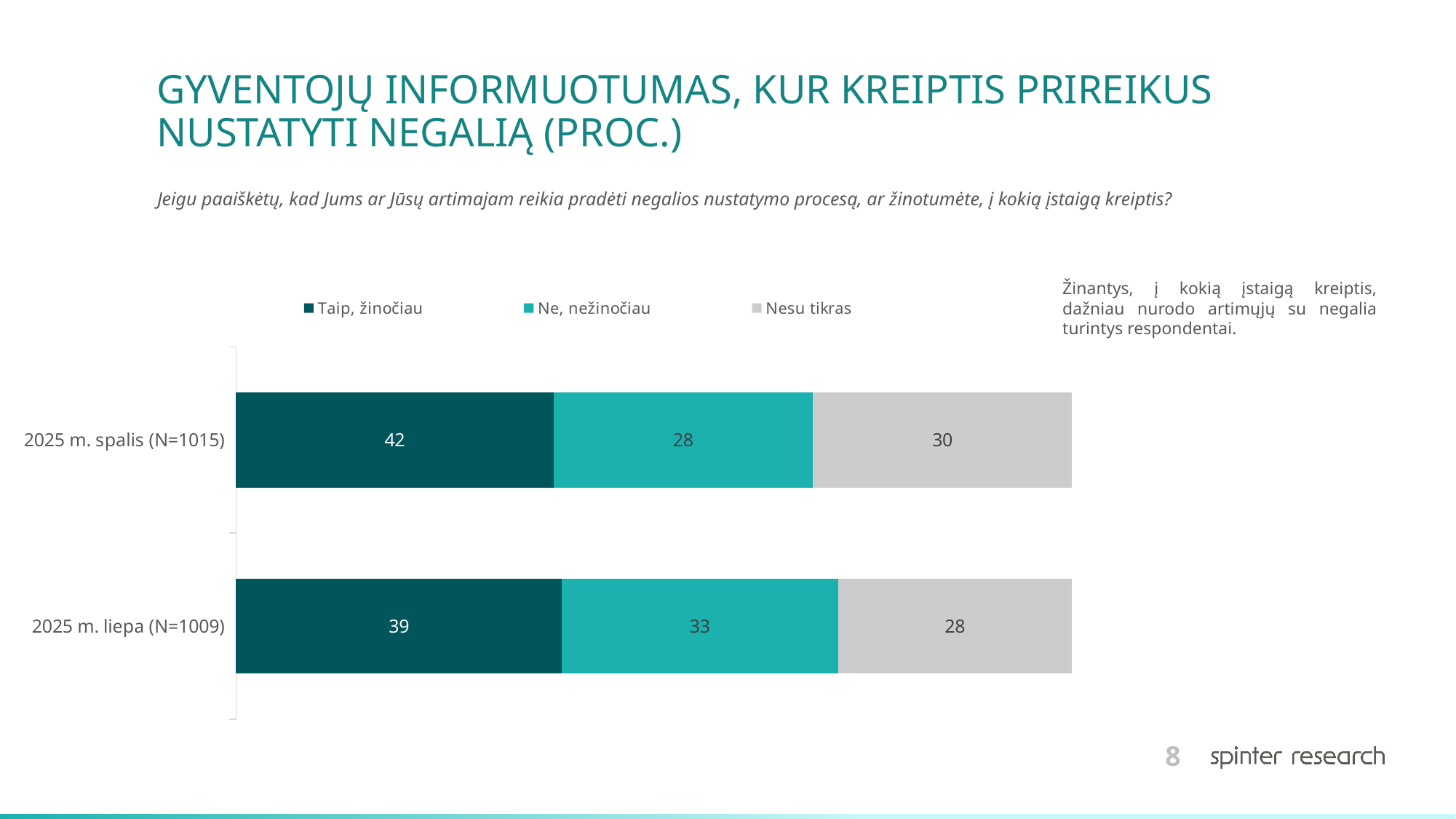
What is the value for "Taip, žinočiau" in 2025 m. liepa (N=1009)? 39 What is the total of the stacked bar for 2025 m. liepa (N=1009)? 100 What is the value for "Taip, žinočiau" in 2025 m. spalis (N=1015)? 42 What is the value for "Nesu tikras" in 2025 m. spalis (N=1015)? 30 How many categories are shown on the chart? 2 What is the value for "Ne, nežinočiau" in 2025 m. liepa (N=1009)? 33 What kind of chart is shown on the slide? Stacked bar chart What is the difference between the "Ne, nežinočiau" values for 2025 m. liepa (N=1009) and 2025 m. spalis (N=1015)? 5 How many series does the legend list? 3 Which is larger: "Nesu tikras" in 2025 m. spalis (N=1015) or "Nesu tikras" in 2025 m. liepa (N=1009)? 2025 m. spalis (N=1015) Which category has the lowest value for "Ne, nežinočiau"? 2025 m. spalis (N=1015) Which category has the highest value for "Taip, žinočiau"? 2025 m. spalis (N=1015)